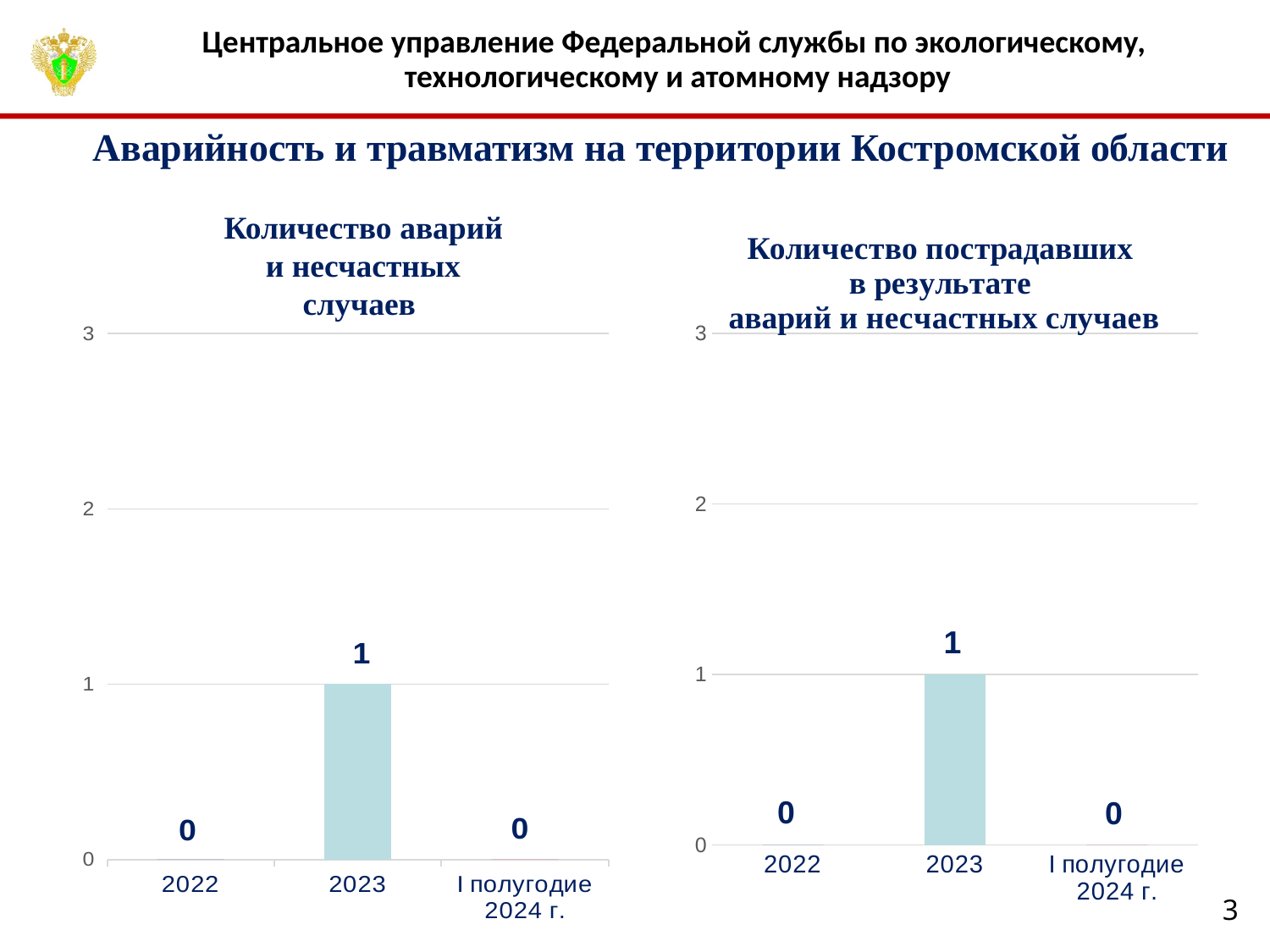
What kind of chart is the right chart 'Количество пострадавших в результате аварий и несчастных случаев'? Bar chart In the right chart 'Количество пострадавших в результате аварий и несчастных случаев', what is the value for I полугодие 2024 г.? 0 In the left chart 'Количество аварий и несчастных случаев', what is the difference between the values for 2023 and 2022? 1 In the right chart 'Количество пострадавших в результате аварий и несчастных случаев', which is larger: the value for 2023 or the value for 2022? 2023 In the left chart 'Количество аварий и несчастных случаев', is the value for 2023 greater or less than 2? less In the right chart 'Количество пострадавших в результате аварий и несчастных случаев', which category has the highest value? 2023 In the left chart 'Количество аварий и несчастных случаев', what is the value for 2022? 0 In the left chart 'Количество аварий и несчастных случаев', what is the value for 2023? 1 In the left chart 'Количество аварий и несчастных случаев', which category has the highest value? 2023 In the right chart 'Количество пострадавших в результате аварий и несчастных случаев', what is the value for 2023? 1 What is the title of the left chart on the slide? Количество аварий и несчастных случаев How many categories are shown on the x axis of the left chart 'Количество аварий и несчастных случаев'? 3